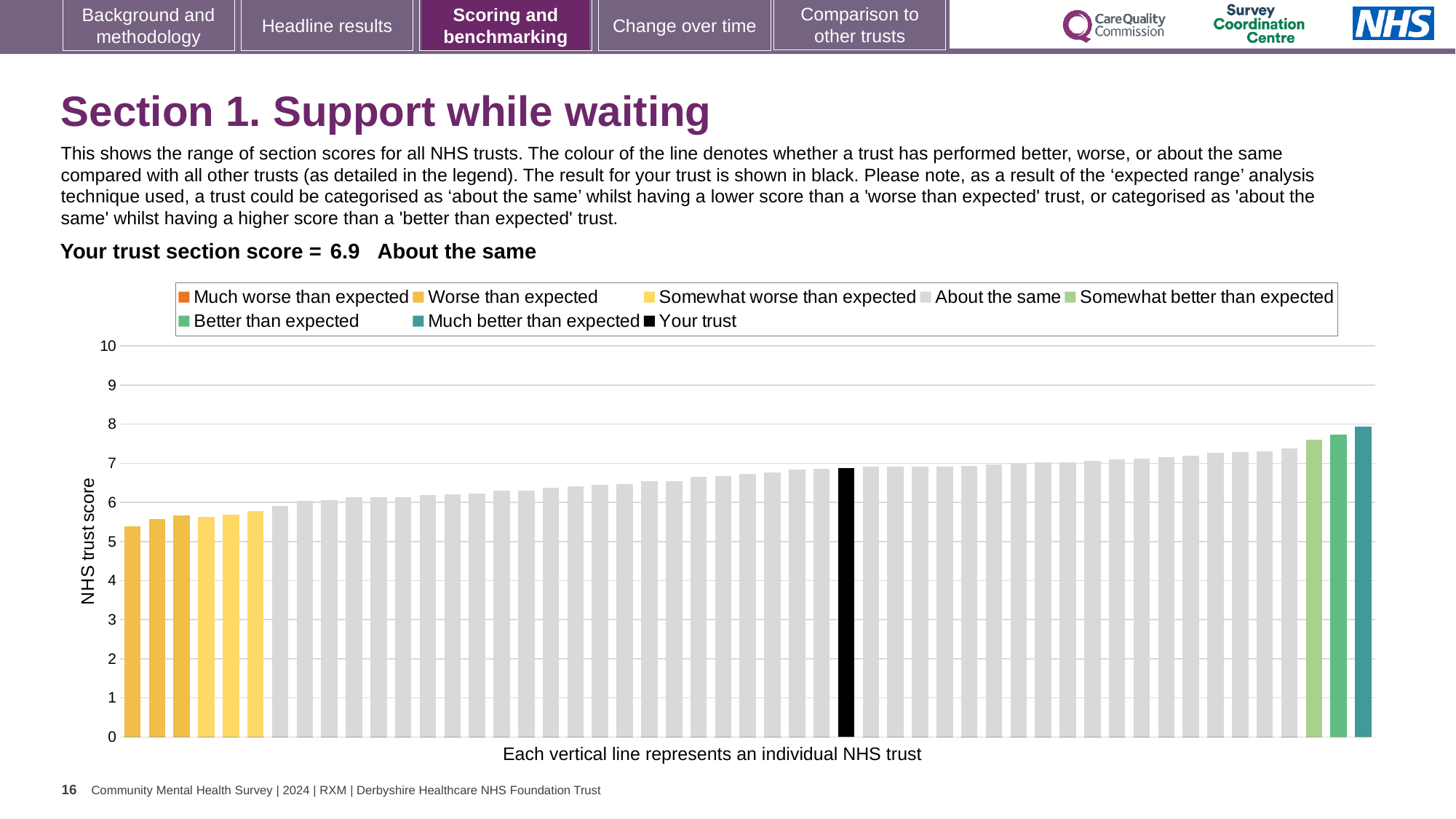
Which category is your trust placed in for this section? About the same Is the value of the highest bar in the chart greater or less than 7? greater How many entries does the chart legend list? 8 How many bars are coloured yellow (worse than expected) at the left of the chart? 6 What is the label on the vertical axis of the chart? NHS trust score What is the section score for your trust shown on the slide? 6.9 What is the highest value shown on the vertical axis? 10 Is the value of the lowest bar in the chart greater or less than 6? less Do the bar values rise or fall from left to right along the x axis? rise Is the value of the black 'Your trust' bar greater or less than 5? greater What kind of chart is shown on the slide? bar chart